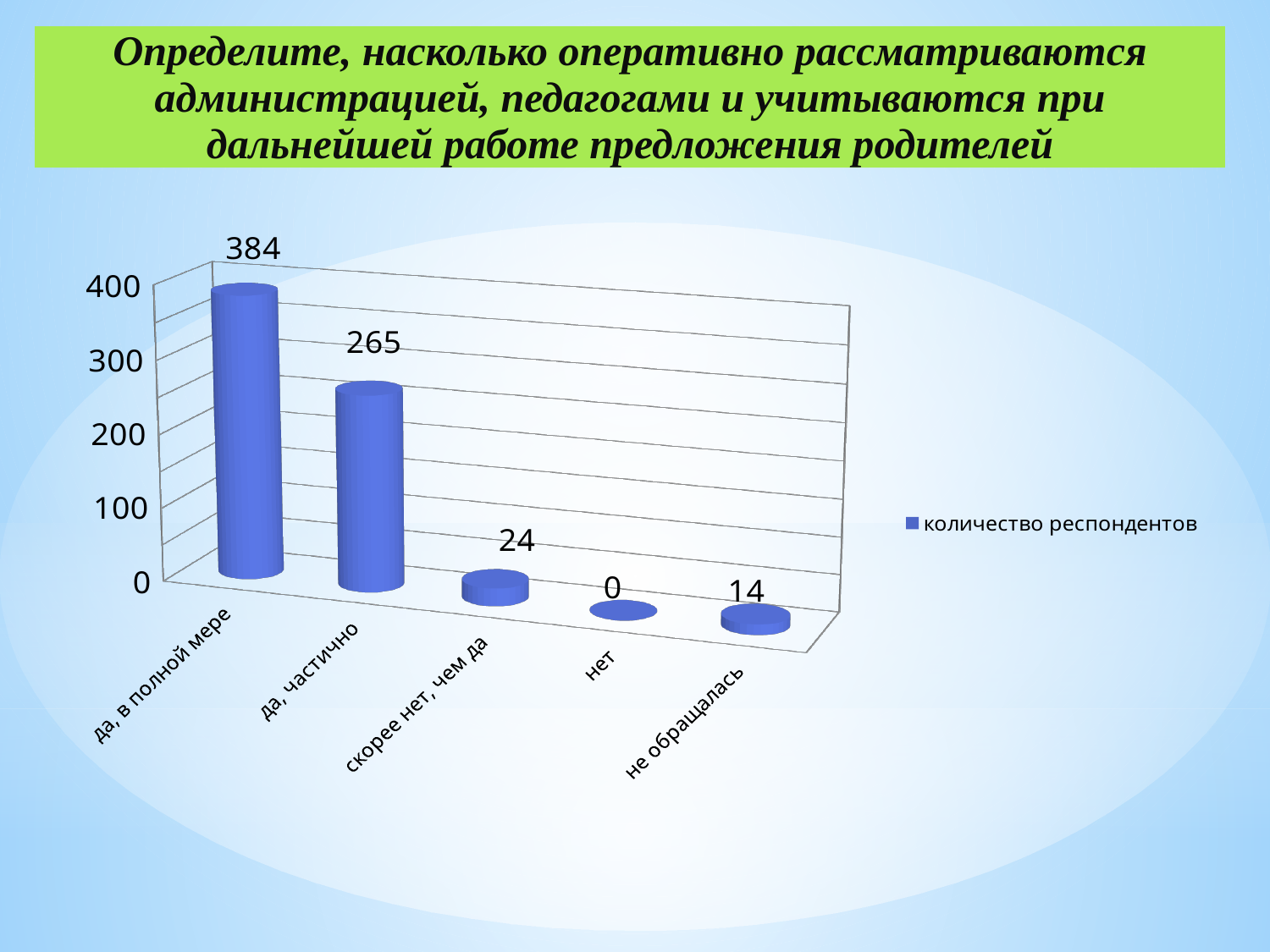
What is the value for "да, в полной мере"? 384 Is the value for "да, частично" greater or less than 200? greater What series name does the legend show? количество респондентов What is the value for "да, частично"? 265 What is the value for "скорее нет, чем да"? 24 Which category has the highest value? да, в полной мере What is the difference between the values for "да, в полной мере" and "да, частично"? 119 Which is larger, the value for "скорее нет, чем да" or the value for "не обращалась"? скорее нет, чем да What kind of chart is shown on the slide? bar chart What is the value for "не обращалась"? 14 How many categories are shown on the x axis? 5 Which category has the lowest value? нет